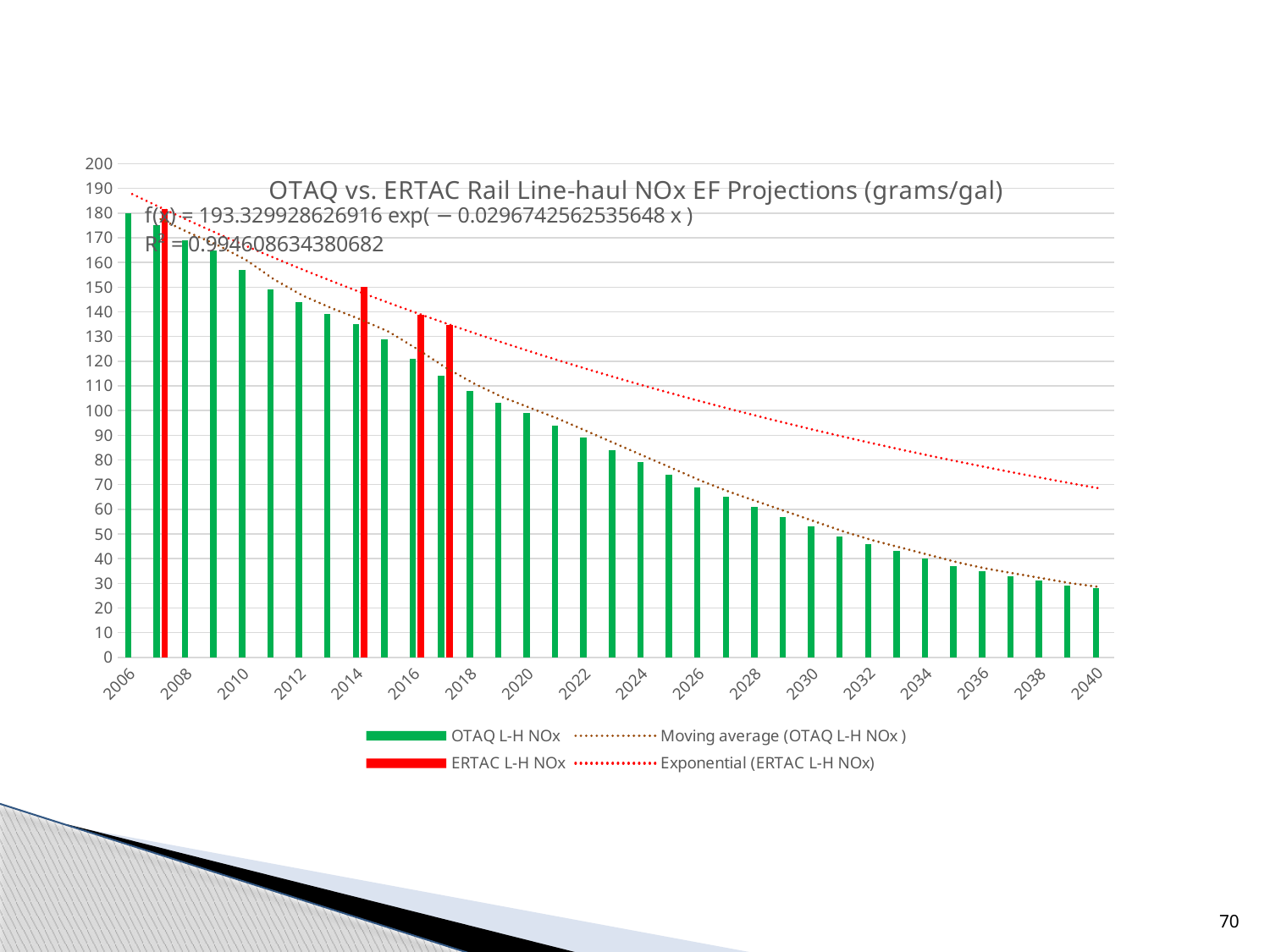
Do the OTAQ L-H NOx values rise or fall from 2006 to 2040? Fall Which series is shown with red bars? ERTAC L-H NOx Which is larger, the OTAQ L-H NOx value for 2010 or for 2020? 2010 What is the title of the chart? OTAQ vs. ERTAC Rail Line-haul NOx EF Projections (grams/gal) Is the OTAQ L-H NOx value for 2006 greater or less than 150? greater In which year is the OTAQ L-H NOx bar highest? 2006 How many red ERTAC L-H NOx bars are plotted? 4 How many entries does the chart legend list? 4 What kind of chart is shown on the slide? Bar chart Is the ERTAC L-H NOx value for 2014 greater or less than 130? greater Is the OTAQ L-H NOx value for 2040 greater or less than 40? less In which year is the OTAQ L-H NOx bar lowest? 2040